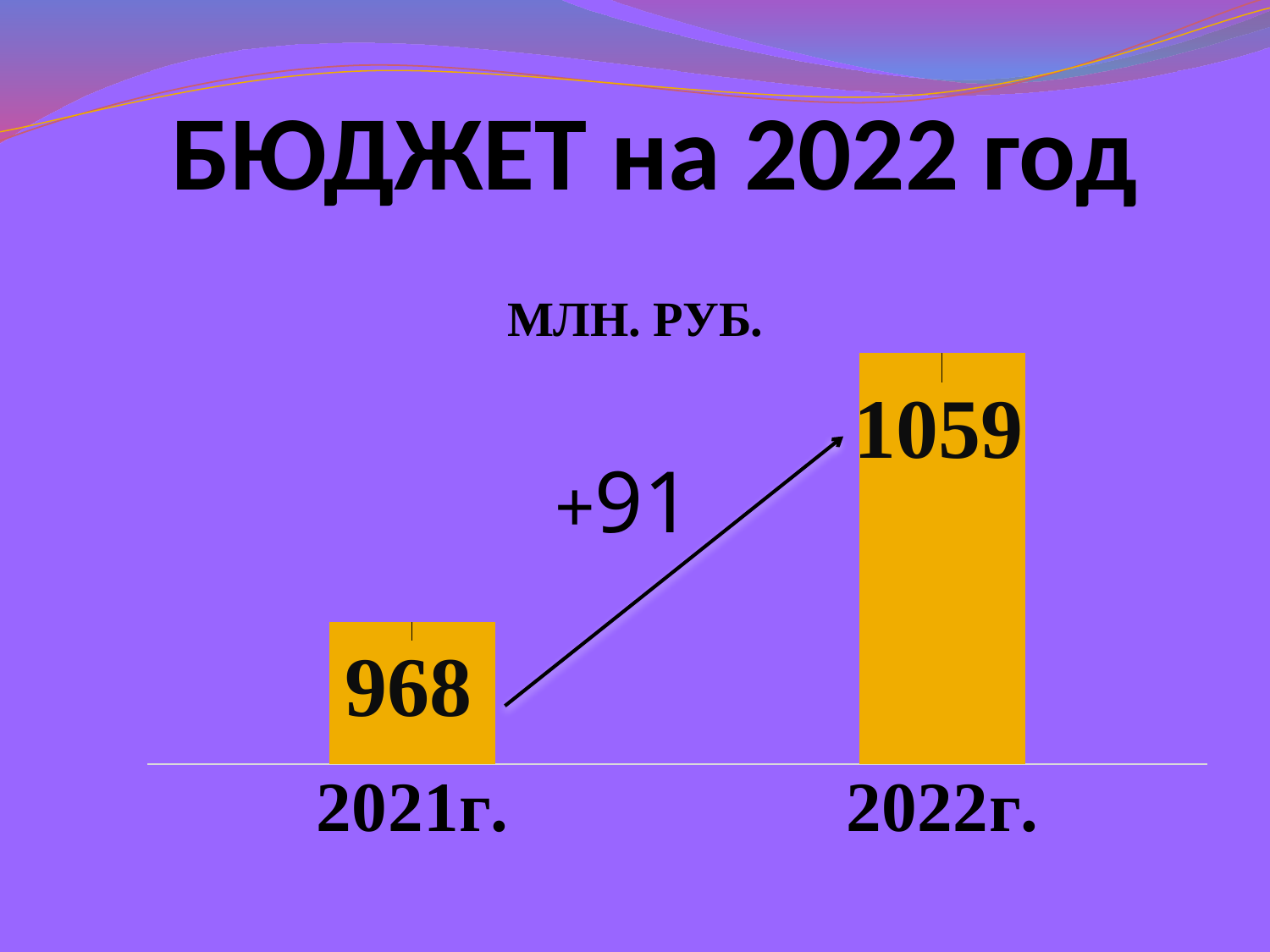
What is the difference between the values for 2022г. and 2021г.? 91 What kind of chart is shown on the slide? bar chart What is the value for 2021г.? 968 Do the values rise or fall from 2021г. to 2022г.? rise Which year has the lower value? 2021г. What is the title of the chart? МЛН. РУБ. What change is written next to the arrow between the two bars? +91 Which year has the higher value? 2022г. Is the value for 2022г. larger or smaller than the value for 2021г.? larger What colour are the bars in the chart? orange What is the value for 2022г.? 1059 How many bars are shown in the chart? 2